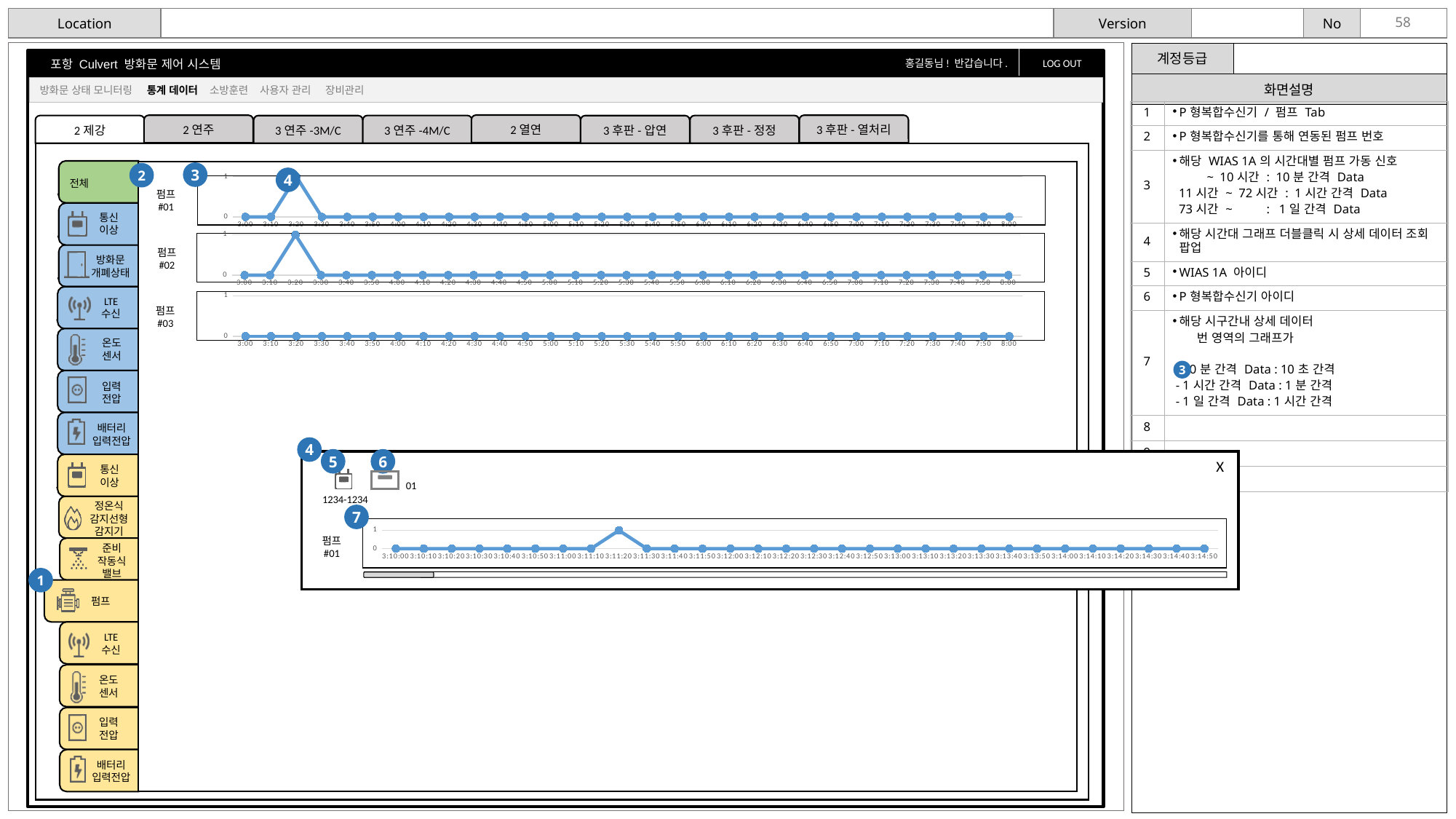
In the 펌프 #01 chart in the main area, which is larger: the value at 3:20 or the value at 3:30? 3:20 In the 펌프 #01 chart in the main area, what is the value at 3:00? 0 In the 펌프 #01 chart in the main area, at which time does the value reach its highest point? 3:20 In the 펌프 #03 chart in the main area, what is the highest value plotted? 0 In the 펌프 #01 chart in the popup window, what is the value at 3:10:00? 0 How many pump charts are shown in the main area (excluding the popup)? 3 What is the highest tick shown on the y axis of the 펌프 #01 chart in the popup window? 1 What kind of chart is used for 펌프 #01 in the main area? line chart In the 펌프 #01 chart in the popup window, at which time does the value reach 1? 3:11:20 In the 펌프 #02 chart in the main area, what is the value at 3:30? 0 In the 펌프 #01 chart in the main area, what is the value at 3:20? 1 In the 펌프 #02 chart in the main area, what is the value at 3:20? 1